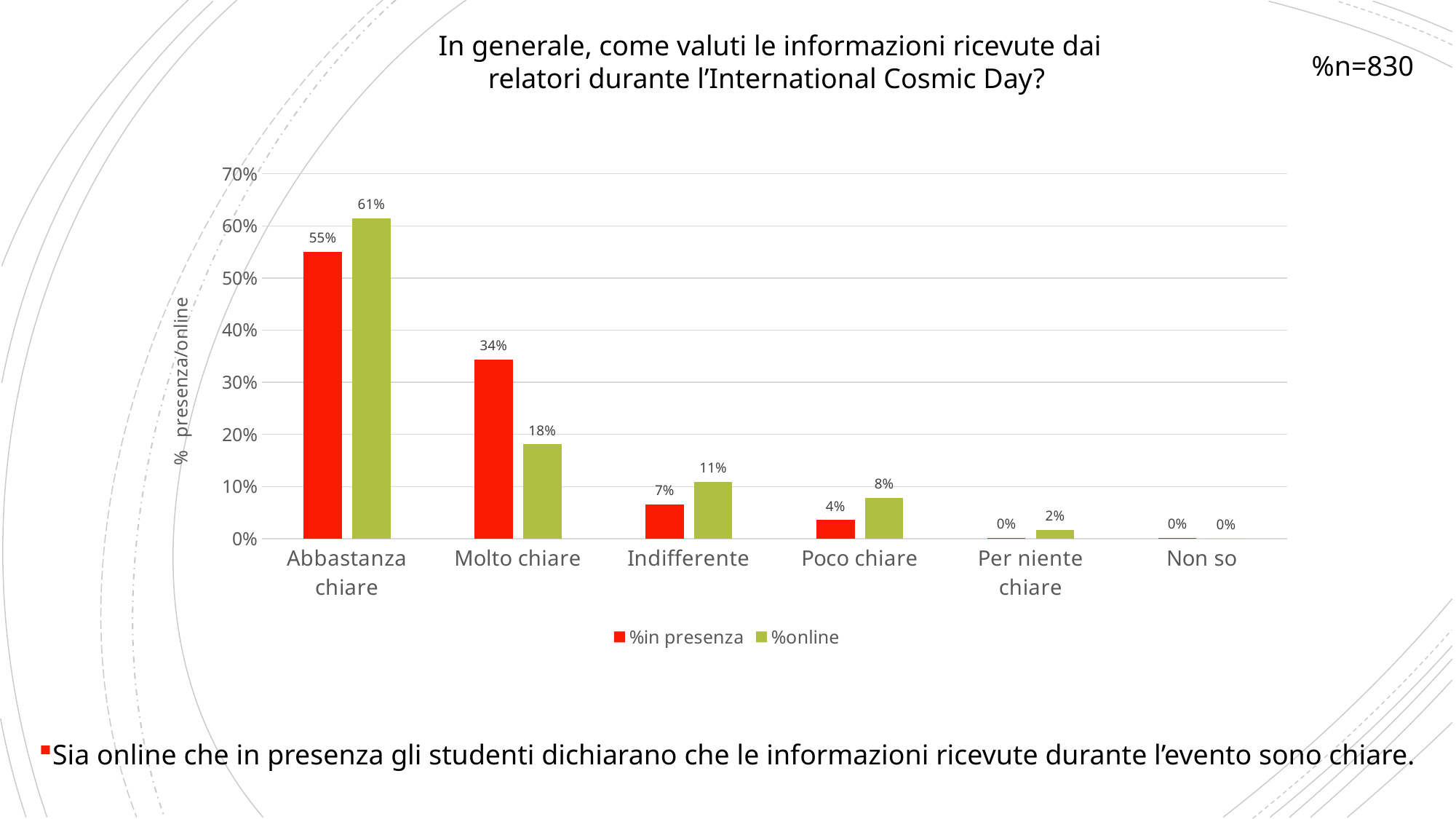
Which category has the highest value for "%online"? Abbastanza chiare How many categories are shown on the x axis? 6 Which is larger for "Indifferente": "%in presenza" or "%online"? %online What is the value for "%in presenza" for "Poco chiare"? 4% What is the difference between the "%in presenza" and "%online" values for "Molto chiare"? 16% What is the difference between the "%online" and "%in presenza" values for "Abbastanza chiare"? 6% What is the value for "%online" for "Indifferente"? 11% What is the value for "%in presenza" for "Abbastanza chiare"? 55% What kind of chart is shown on the slide? Bar chart What is the value for "%online" for "Molto chiare"? 18% What is the label of the y axis? % presenza/online How many series does the legend list? 2